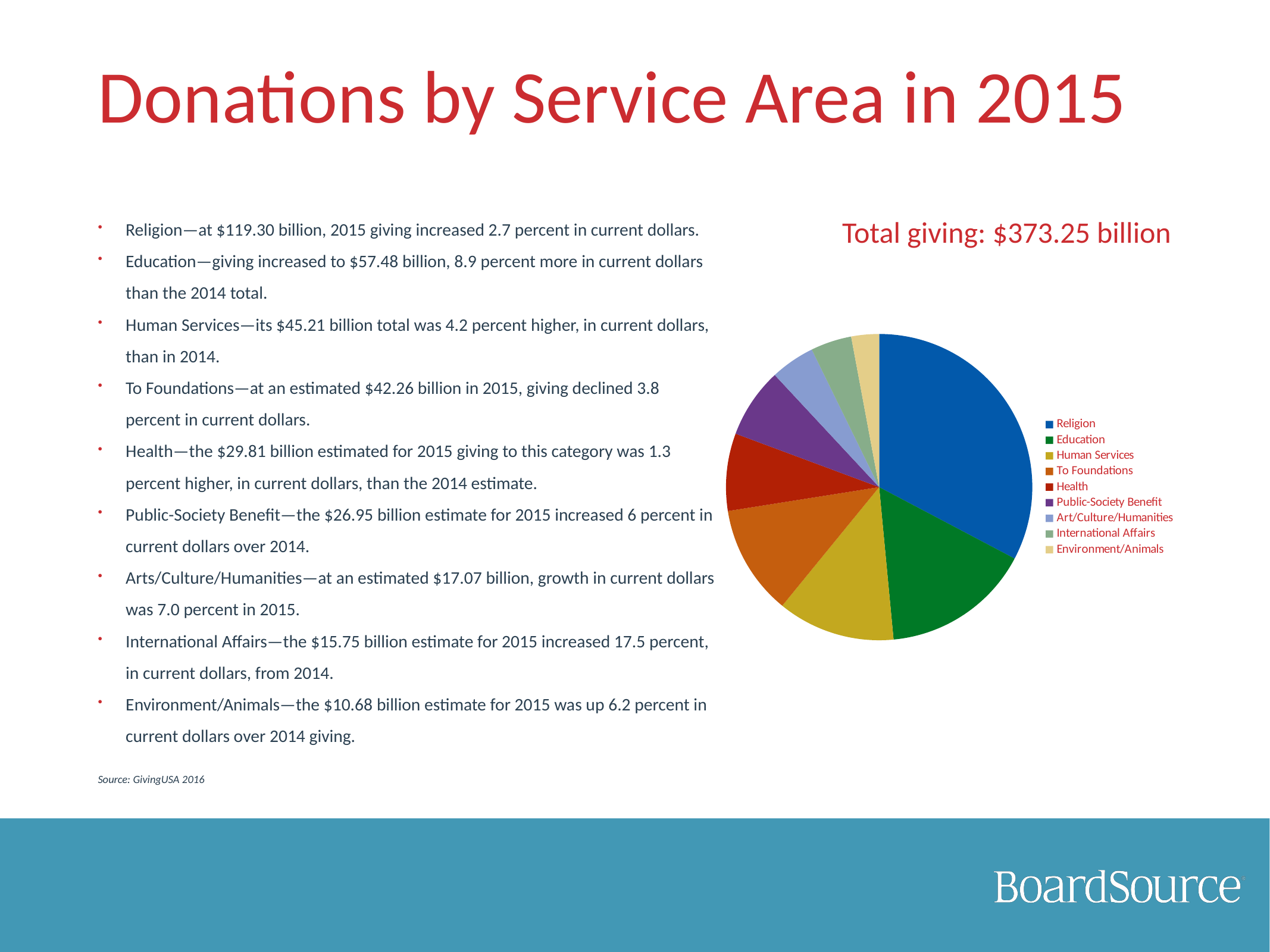
Which service area has the smallest slice of the pie chart? Environment/Animals Which slice is larger in the pie chart, To Foundations or Health? To Foundations Which service area has the largest slice of the pie chart? Religion What total giving figure is printed above the pie chart? $373.25 billion What kind of chart is shown on the slide? Pie chart According to the slide, how much was given to Education in 2015? $57.48 billion What colour represents Religion in the pie chart legend? Blue According to the slide, how much was given to International Affairs in 2015? $15.75 billion Which slice is larger in the pie chart, Education or Human Services? Education Using the values printed on the slide, how much more was given to Religion than to Education in 2015? $61.82 billion According to the slide, how much was given to Religion in 2015? $119.30 billion How many service areas (slices) does the pie chart show? 9